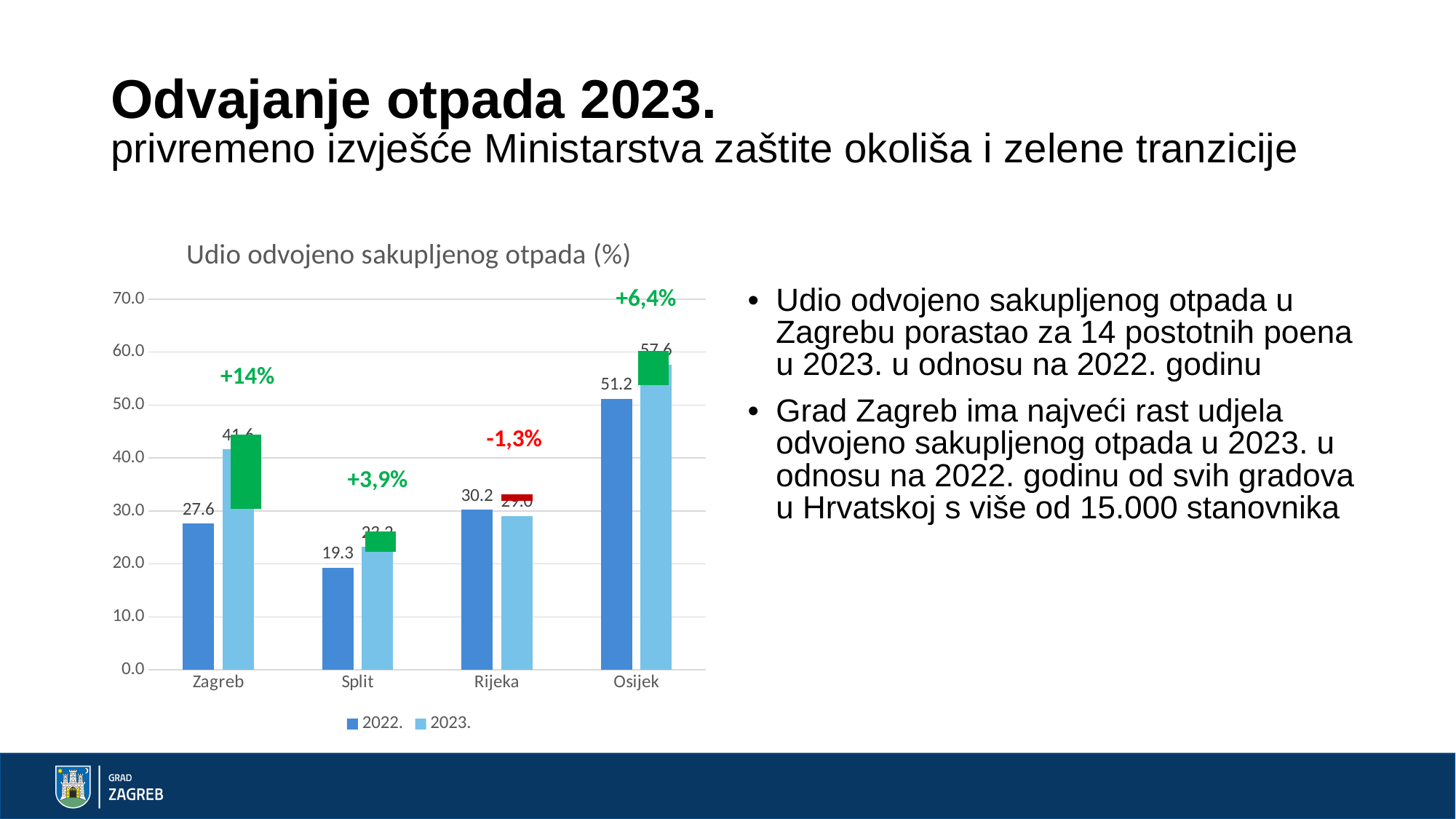
What is the value for Split in the 2022. series? 19.3 What is the value for Rijeka in the 2022. series? 30.2 What is the value for Zagreb in the 2022. series? 27.6 How many series does the chart legend list? 2 In the 2022. series, which is larger: Rijeka or Zagreb? Rijeka Is the 2023. value for Osijek greater or less than 50.0? greater What is the difference between the 2022. values for Osijek and Zagreb? 23.6 What kind of chart is shown on the slide? bar chart Which city has the highest value in the 2022. series? Osijek How many cities are shown on the x axis of the chart? 4 Which city has the lowest value in the 2022. series? Split What is the value for Osijek in the 2022. series? 51.2